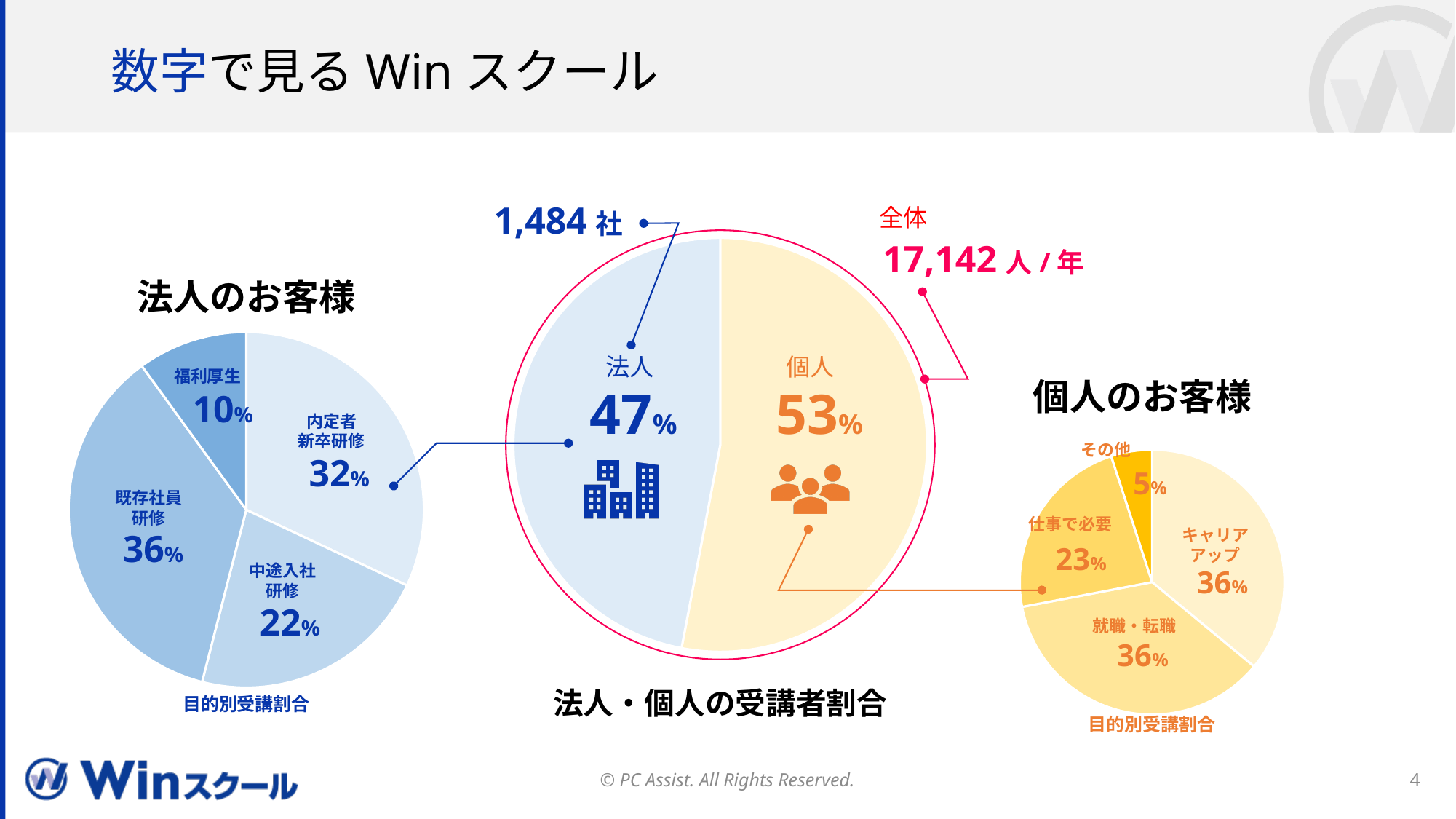
In the right chart titled 個人のお客様, what percentage is shown for 仕事で必要? 23% In the left chart titled 法人のお客様, what percentage is shown for 既存社員研修? 36% In the center chart titled 法人・個人の受講者割合, what percentage is shown for 法人? 47% In the left chart titled 法人のお客様, which category has the smallest share? 福利厚生 In the left chart titled 法人のお客様, how many categories are shown? 4 In the right chart titled 個人のお客様, what percentage is shown for その他? 5% In the center chart titled 法人・個人の受講者割合, which segment is larger, 法人 or 個人? 個人 In the left chart titled 法人のお客様, what percentage is shown for 福利厚生? 10% In the center chart titled 法人・個人の受講者割合, what percentage is shown for 個人? 53% In the right chart titled 個人のお客様, which category has the smallest share? その他 In the left chart titled 法人のお客様, what is the difference in percentage points between 内定者新卒研修 and 中途入社研修? 10 What kind of chart is the center chart titled 法人・個人の受講者割合? pie chart